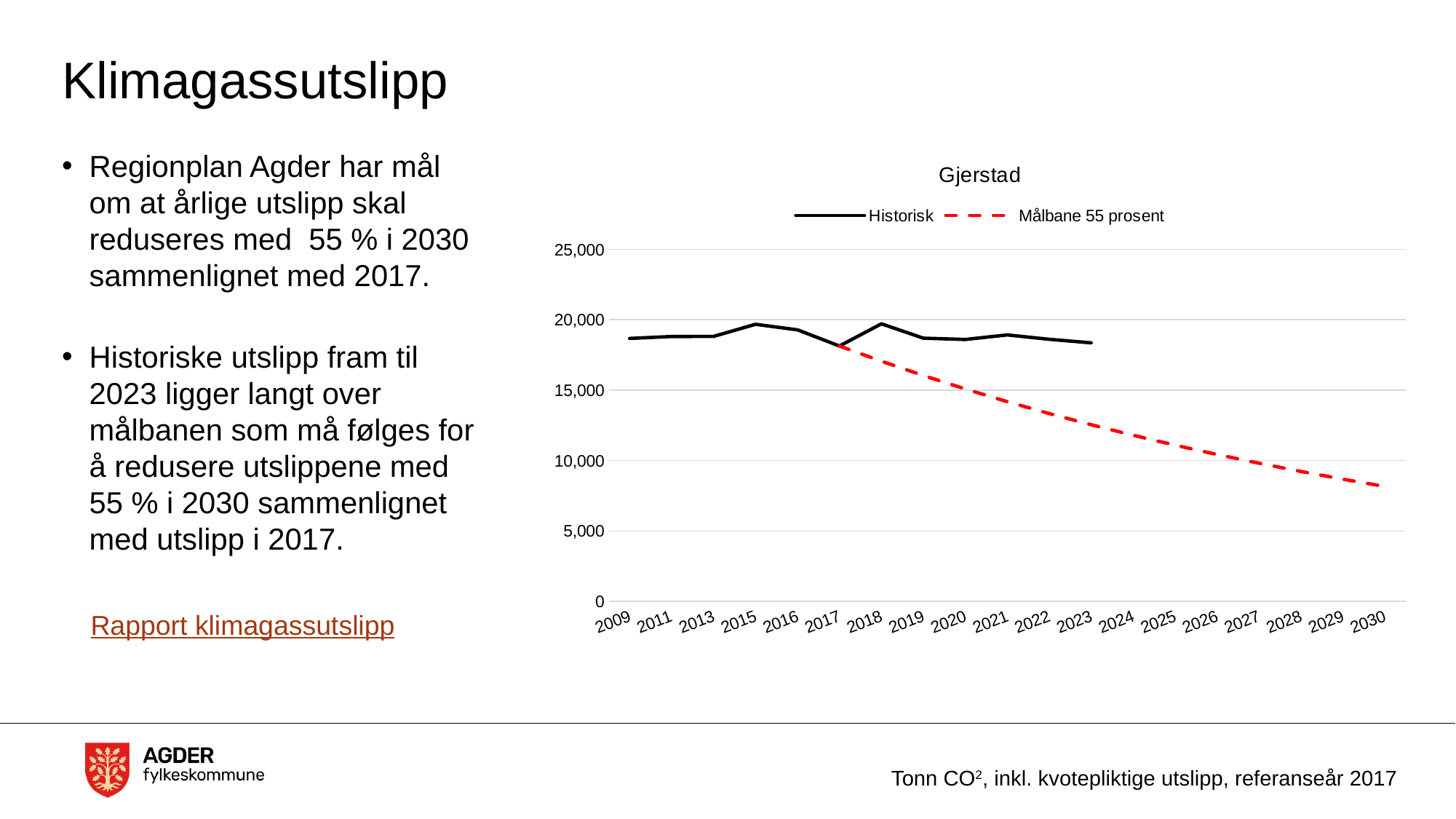
What kind of chart is shown on the slide? Line chart What is the title of the chart? Gjerstad Is the Historisk value for 2023 greater or less than 15,000? greater Does the Målbane 55 prosent line rise or fall from 2017 to 2030? Fall How many year labels are shown on the x axis? 19 How many series does the chart legend list? 2 Is the Historisk value for 2009 greater or less than 15,000? greater Is the Målbane 55 prosent value for 2030 greater or less than 10,000? less For the Målbane 55 prosent series, which year has the higher value, 2017 or 2030? 2017 Which series is drawn as a red dashed line? Målbane 55 prosent In 2023, which series has the higher value, Historisk or Målbane 55 prosent? Historisk